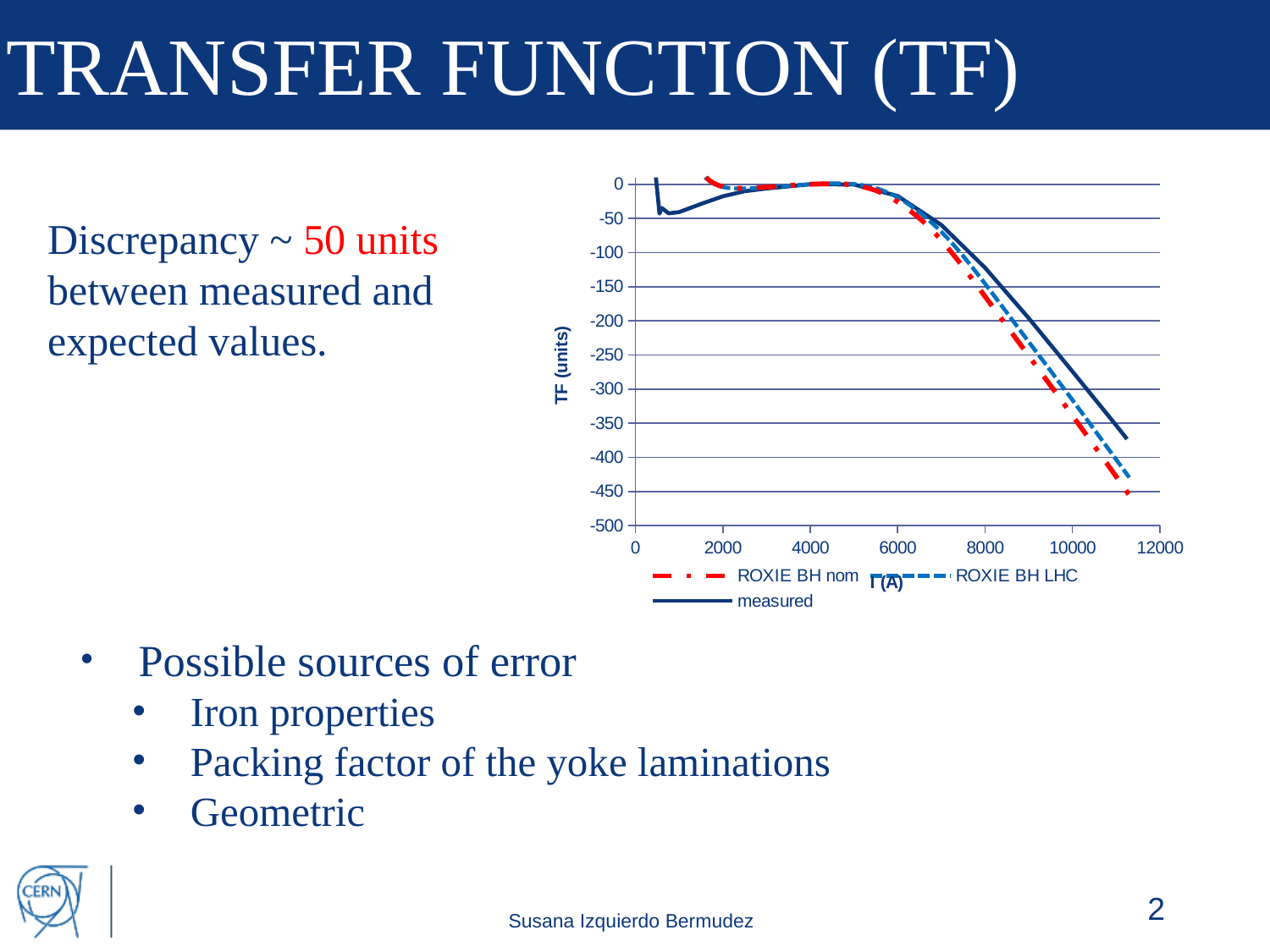
Which series reaches the lowest TF value at the high-current end of the chart? ROXIE BH nom How many series does the chart legend list? 3 At 10000 A, which series has the higher TF value: measured or ROXIE BH nom? measured How many tick labels are shown on the horizontal axis of the chart? 7 At 10000 A, is the TF value of the measured series greater or less than -400? greater Which series are listed in the chart legend? ROXIE BH nom, ROXIE BH LHC, measured At the end of the ROXIE BH nom curve (around 11000 A), is the TF value greater or less than -400? less What kind of chart is shown on the slide? line chart What is the label of the vertical axis of the chart? TF (units) What is the lowest value shown on the vertical axis of the chart? -500 Do the TF values rise or fall as the current I increases beyond about 4000 A? fall At 10000 A, is the TF value of the ROXIE BH LHC series greater or less than -450? greater